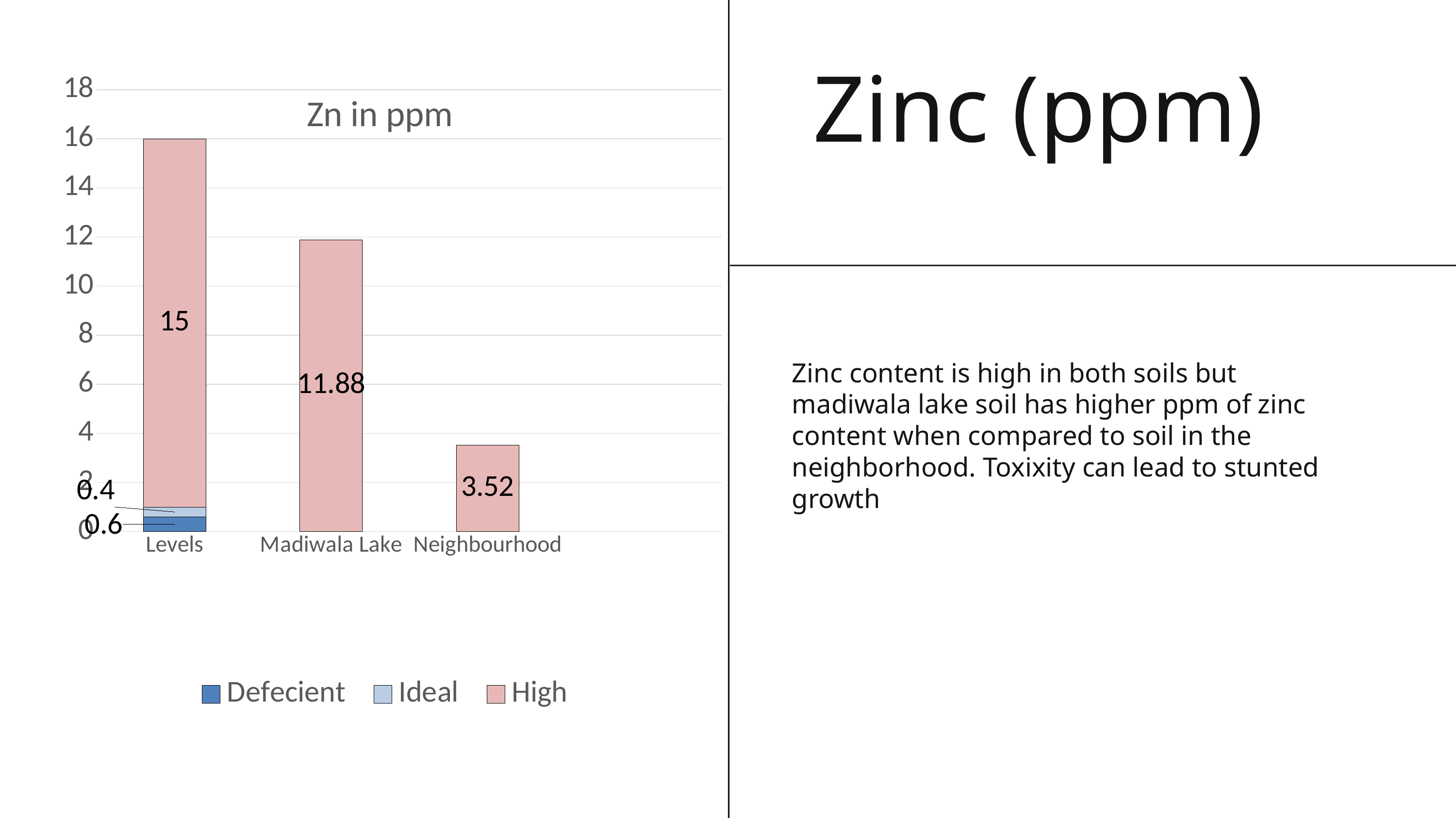
What is the High value for Madiwala Lake? 11.88 What is the Defecient value for the Levels bar? 0.6 What is the High value for Neighbourhood? 3.52 How many categories are shown on the x axis? 3 Which has a higher High value, Madiwala Lake or Neighbourhood? Madiwala Lake Is the value for Madiwala Lake greater or less than 10? greater What kind of chart is shown on the slide? bar chart How many series does the legend list? 3 What is the total of the stacked Levels bar? 16 What is the High value for the Levels bar? 15 What is the difference between the High values for Madiwala Lake and Neighbourhood? 8.36 What is the Ideal value for the Levels bar? 0.4